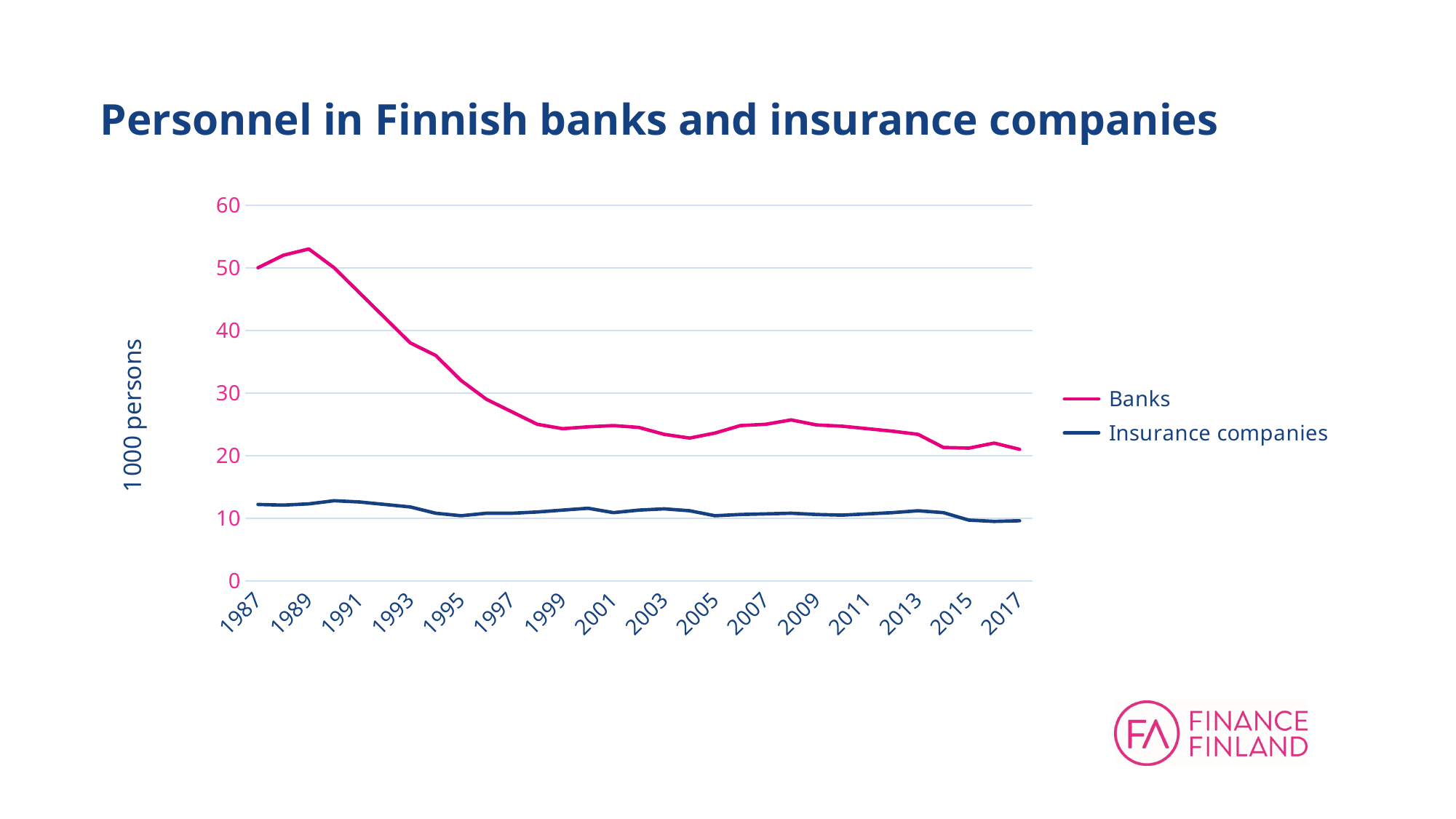
Is the value for Banks in 1987 greater or less than 40? greater What is the title of the chart? Personnel in Finnish banks and insurance companies Which series has the higher value in 2005, Banks or Insurance companies? Banks How many year labels are shown on the x axis? 16 Does the Banks series rise or fall overall from 1987 to 2017? Fall In which year does the Banks series reach its highest value? 1989 What kind of chart is shown on the slide? Line chart Is the value for Banks in 2017 greater or less than 30? less Is the value for Banks in 1989 greater or less than 50? greater What is the label on the vertical axis? 1000 persons How many series does the legend list? 2